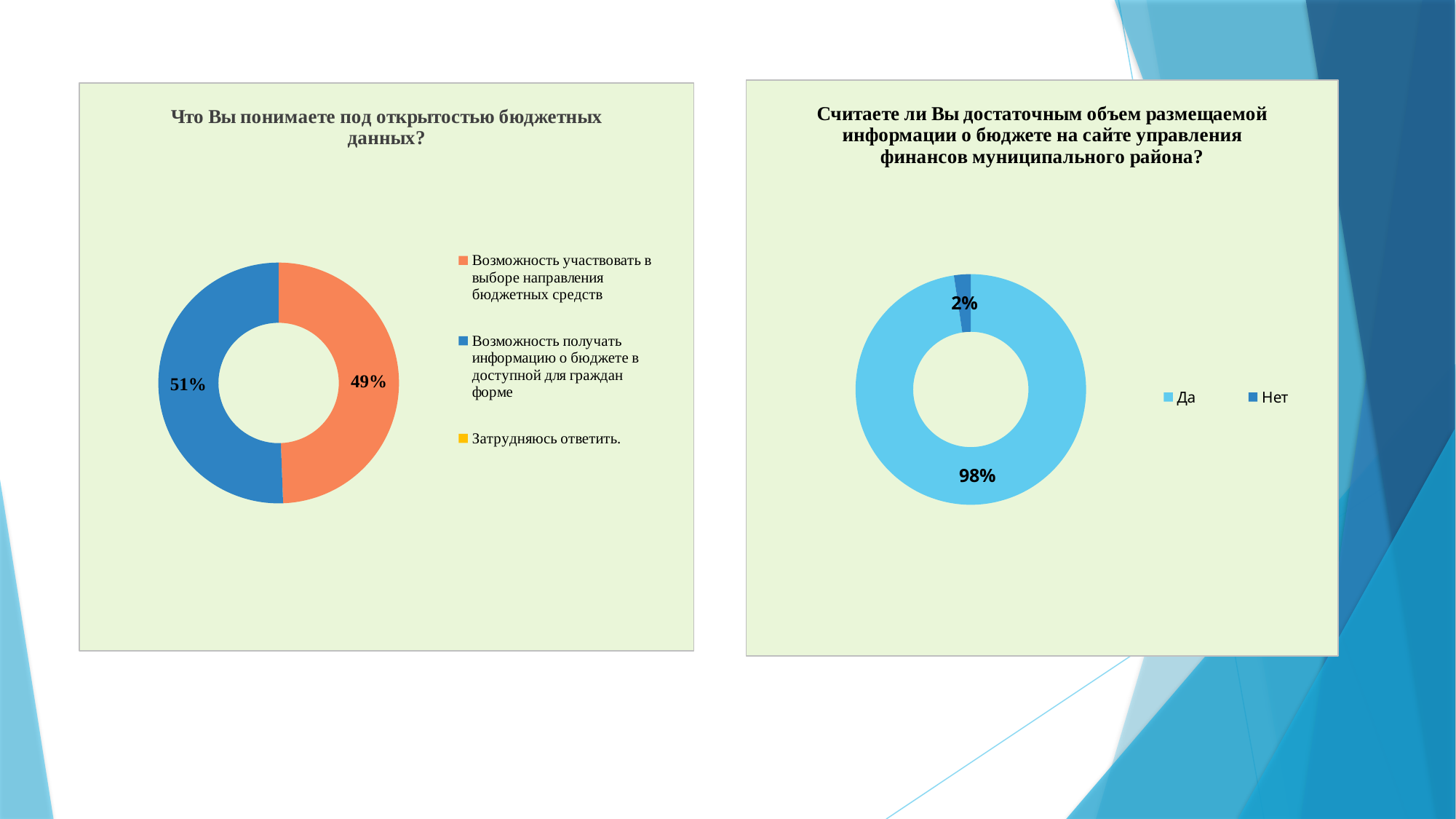
In the left chart, which answer option has the larger share? Возможность получать информацию о бюджете в доступной для граждан форме In the right chart, what share of respondents answered 'Нет'? 2% In the left chart, what is the difference between the 51% and 49% slices? 2% In the right chart, what is the difference between the 'Да' and 'Нет' shares? 96% In the right chart, what share of respondents answered 'Да'? 98% In the left chart, what colour is the slice labelled 49%? Orange How many entries does the legend of the right chart list? 2 In the left chart, what share of respondents chose 'Возможность получать информацию о бюджете в доступной для граждан форме'? 51% In the left chart, what share of respondents chose 'Возможность участвовать в выборе направления бюджетных средств'? 49% How many entries does the legend of the left chart list? 3 What type of chart is the left chart? Doughnut (pie) chart In the right chart, which answer has the smallest share? Нет